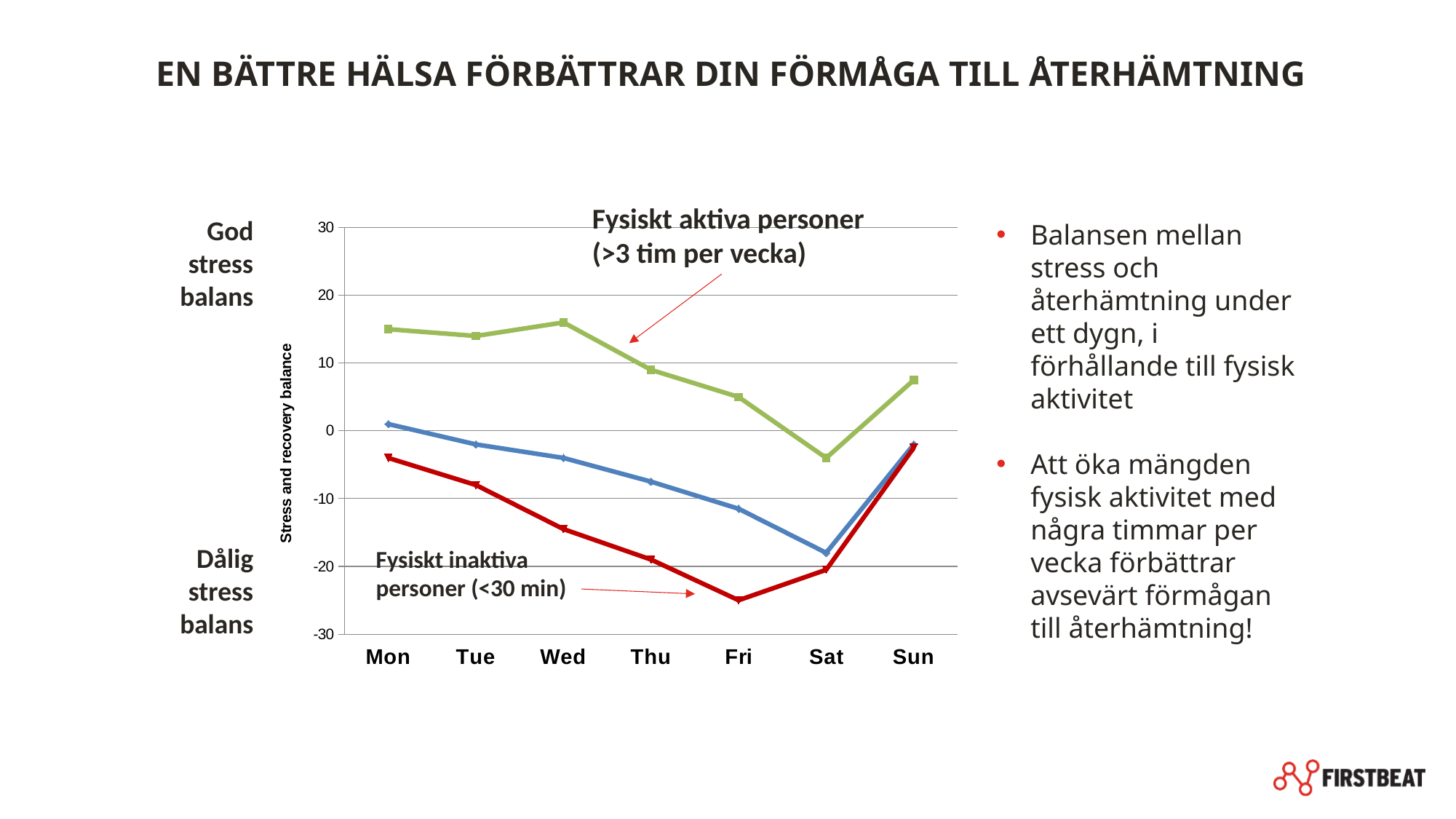
On which day does the physically active group (Fysiskt aktiva personer) reach its lowest value? Sat Which group does the green line with square markers represent? Fysiskt aktiva personer (>3 tim per vecka) How many days are plotted along the x axis of the chart? 7 On Fri, which group has the higher stress and recovery balance: the physically active group or the physically inactive group? Fysiskt aktiva personer On which day does the physically inactive group (Fysiskt inaktiva personer) reach its lowest value? Fri Is the value for the physically active group (Fysiskt aktiva personer) on Mon greater or less than 10? greater What is the label of the vertical axis of the chart? Stress and recovery balance Does the line for the physically inactive group (Fysiskt inaktiva personer) rise or fall from Mon to Fri? fall Is the value for the physically inactive group (Fysiskt inaktiva personer) on Wed greater or less than -10? less What kind of chart is shown on the slide? line chart Is the value for the physically inactive group (Fysiskt inaktiva personer) on Fri greater or less than -20? less